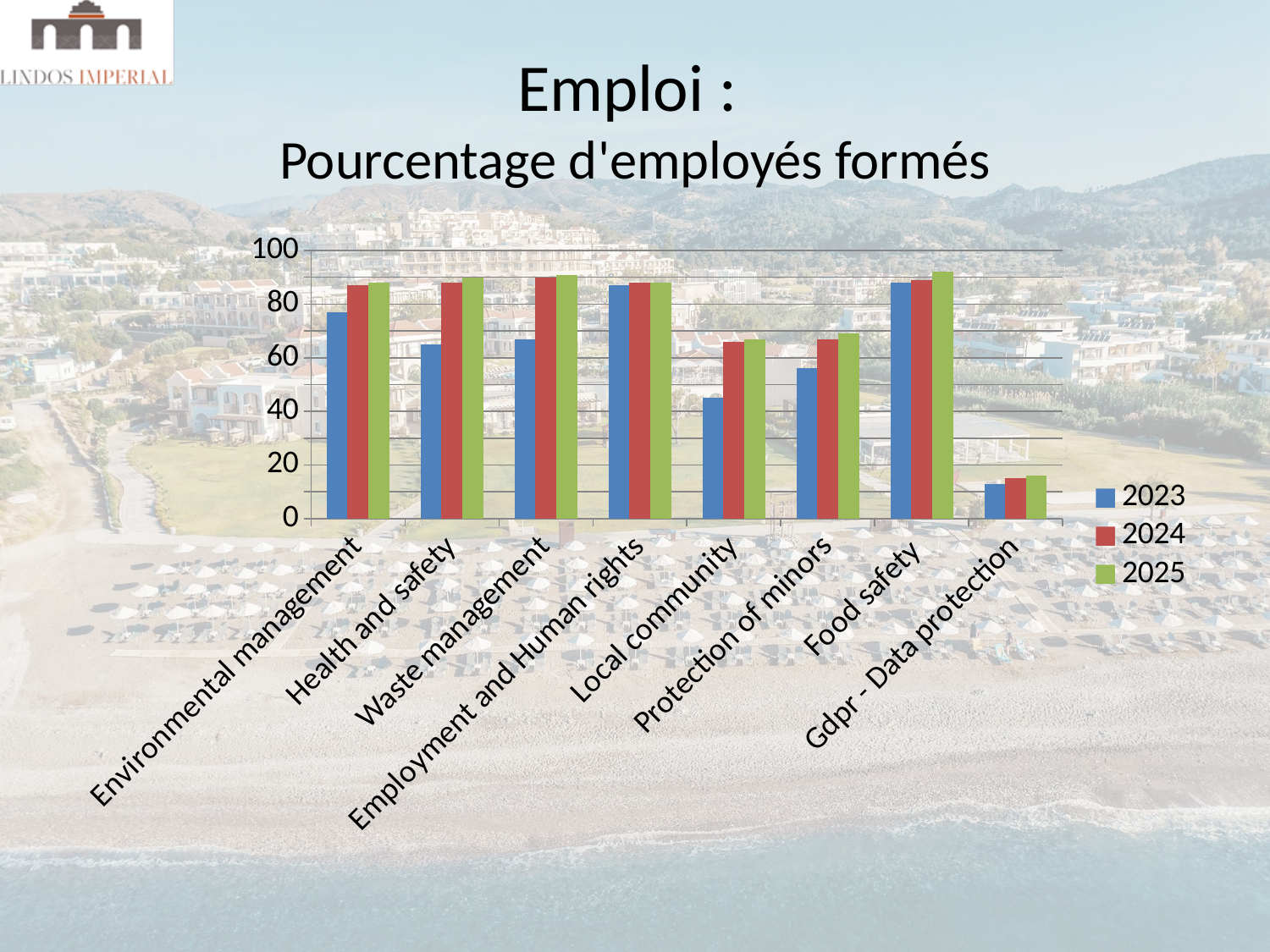
What kind of chart is shown on the slide? bar chart For Health and safety, which year has the larger value: 2023 or 2024? 2024 How many categories are shown on the x axis of the chart? 8 Which category has the lowest value for 2023? Gdpr - Data protection What is the title of the chart on the slide? Emploi : Pourcentage d'employés formés Is the value for Protection of minors in 2023 greater or less than 40? greater Is the value for Local community in 2023 greater or less than 60? less How many series does the legend list? 3 Which is larger for 2023: Local community or Protection of minors? Protection of minors Is the value for Gdpr - Data protection in 2025 greater or less than 20? less Does the value for Local community rise or fall from 2023 to 2024? rise